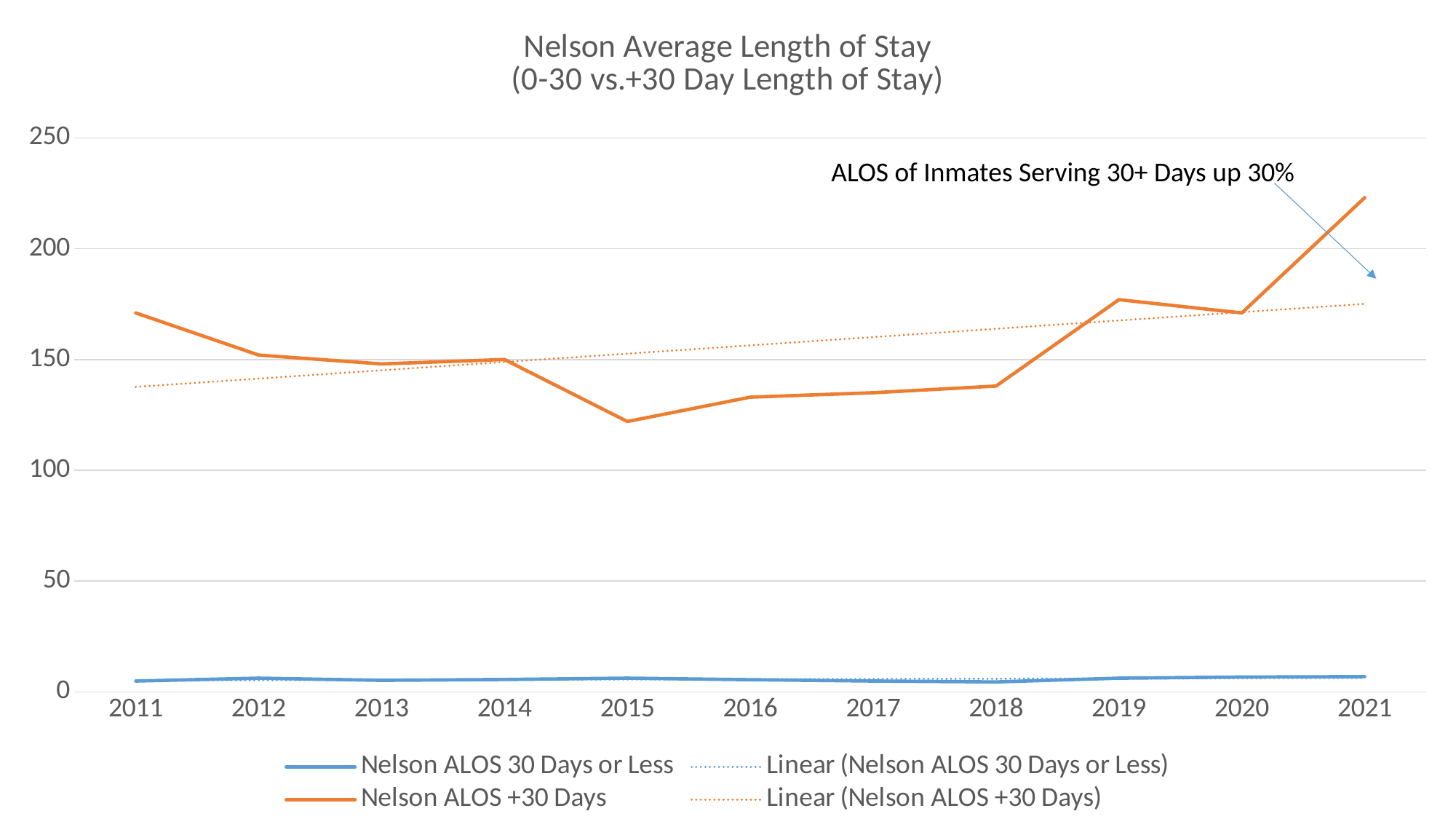
In which year is the Nelson ALOS +30 Days value lowest? 2015 Is the Nelson ALOS +30 Days value for 2021 greater or less than 200? greater Is the Nelson ALOS 30 Days or Less value for 2021 greater or less than 50? less Is the Nelson ALOS +30 Days value for 2015 greater or less than 150? less How many years are shown on the x axis? 11 In which year is the Nelson ALOS +30 Days value highest? 2021 What is the title of the chart? Nelson Average Length of Stay (0-30 vs.+30 Day Length of Stay) What kind of chart is shown on the slide? line chart Which year has the larger Nelson ALOS +30 Days value, 2011 or 2015? 2011 How many series does the legend list? 4 Does the Nelson ALOS +30 Days line rise or fall from 2018 to 2021? rise